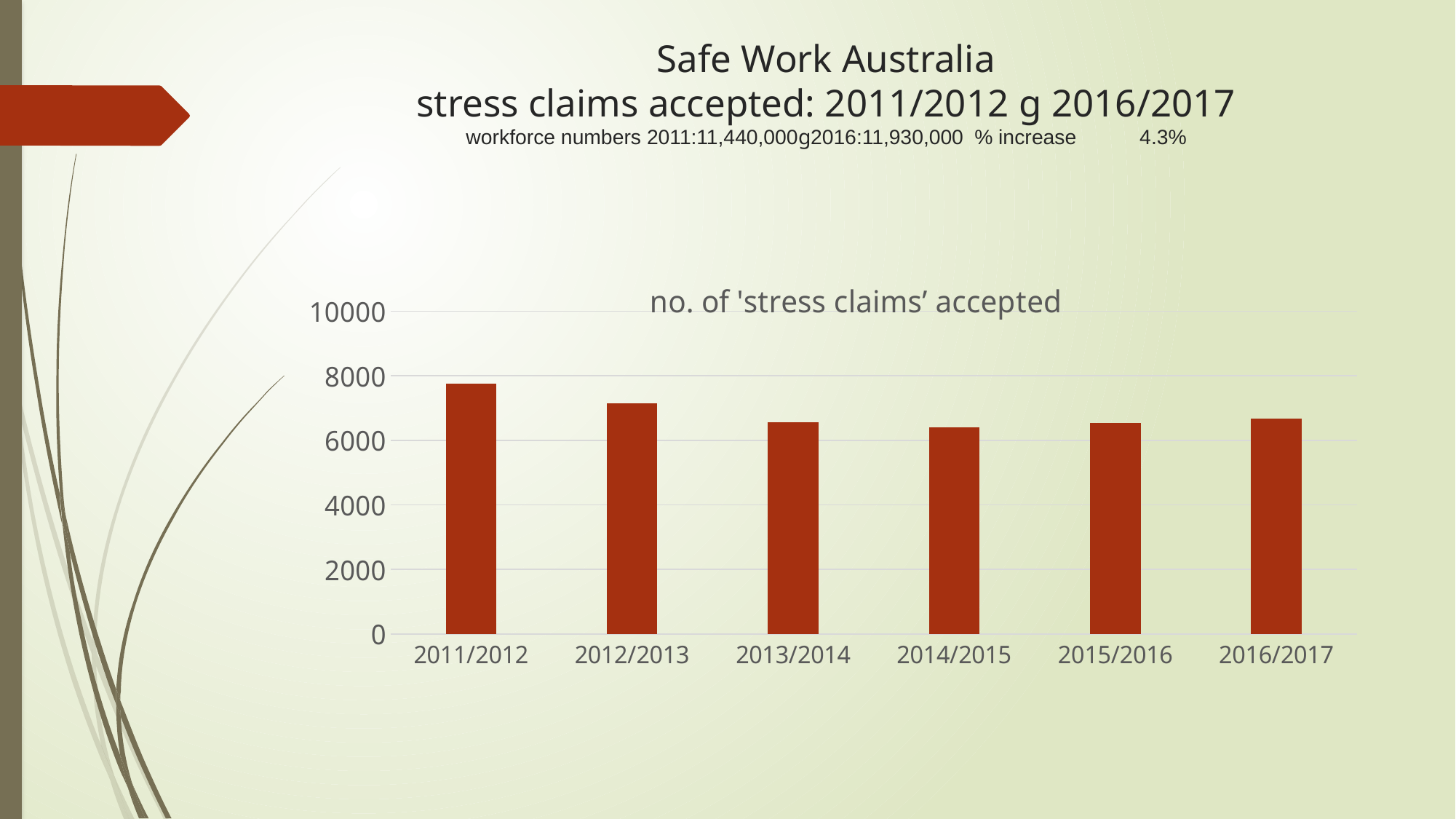
Which year has the lowest number of stress claims accepted? 2014/2015 What is the highest value shown on the chart's vertical axis? 10000 Do the values rise or fall from 2011/2012 to 2014/2015? fall Is the value for 2012/2013 greater or less than 8000? less Is the value for 2016/2017 greater or less than 8000? less Is the value for 2014/2015 greater or less than 6000? greater What is the title of the chart? no. of 'stress claims' accepted Which year has more stress claims accepted, 2011/2012 or 2012/2013? 2011/2012 What kind of chart is shown on the slide? bar chart Which year has the highest number of stress claims accepted? 2011/2012 How many financial years are shown on the x axis of the chart? 6